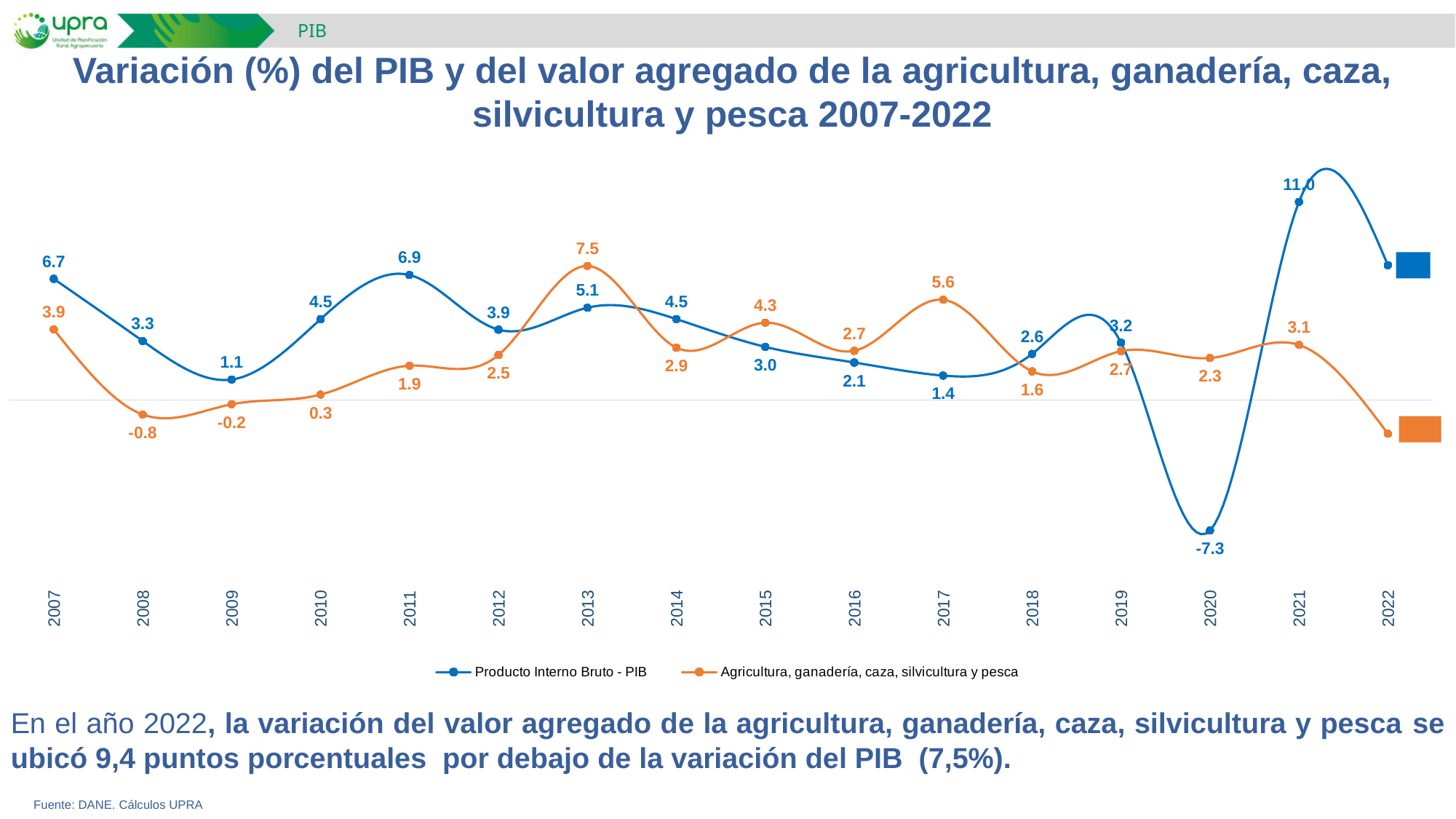
How many years are shown on the x axis? 16 In 2013, what is the difference between the Agricultura, ganadería, caza, silvicultura y pesca value and the Producto Interno Bruto - PIB value? 2.4 What kind of chart is shown on the slide? line chart What is the value of Producto Interno Bruto - PIB in 2011? 6.9 In which year is the Agricultura, ganadería, caza, silvicultura y pesca value highest? 2013 In 2017, which series has the larger value: Producto Interno Bruto - PIB or Agricultura, ganadería, caza, silvicultura y pesca? Agricultura, ganadería, caza, silvicultura y pesca In which year is the Producto Interno Bruto - PIB value lowest? 2020 How many series does the legend list? 2 What is the value of Agricultura, ganadería, caza, silvicultura y pesca in 2013? 7.5 In which year is the Producto Interno Bruto - PIB value highest? 2021 In which year is the Agricultura, ganadería, caza, silvicultura y pesca value lowest? 2022 What is the value of Producto Interno Bruto - PIB in 2020? -7.3